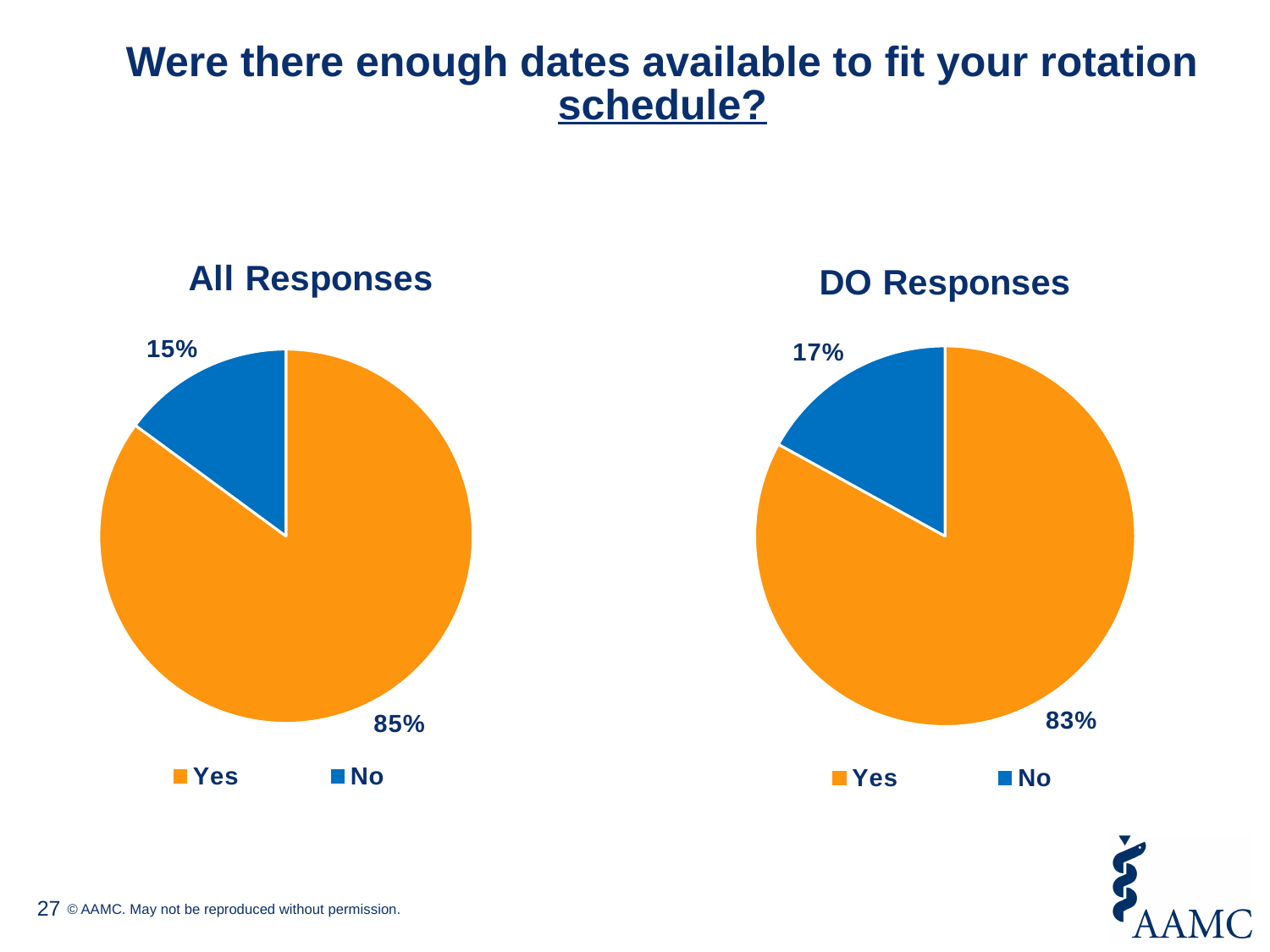
In the "DO Responses" chart, which response has the smallest share? No In the "All Responses" chart, what colour represents the Yes slice? Orange What is the difference between the Yes and No shares in the "All Responses" chart? 70% What is the difference between the Yes and No shares in the "DO Responses" chart? 66% Is the No share larger in the "All Responses" chart or the "DO Responses" chart? DO Responses In the "All Responses" chart, which response has the largest share? Yes In the "All Responses" chart, what percentage of respondents answered No? 15% In the "All Responses" chart, what percentage of respondents answered Yes? 85% How many categories does the legend of the "DO Responses" chart list? 2 In the "DO Responses" chart, what percentage of respondents answered No? 17% In the "DO Responses" chart, what percentage of respondents answered Yes? 83% What type of chart is used for "All Responses"? Pie chart